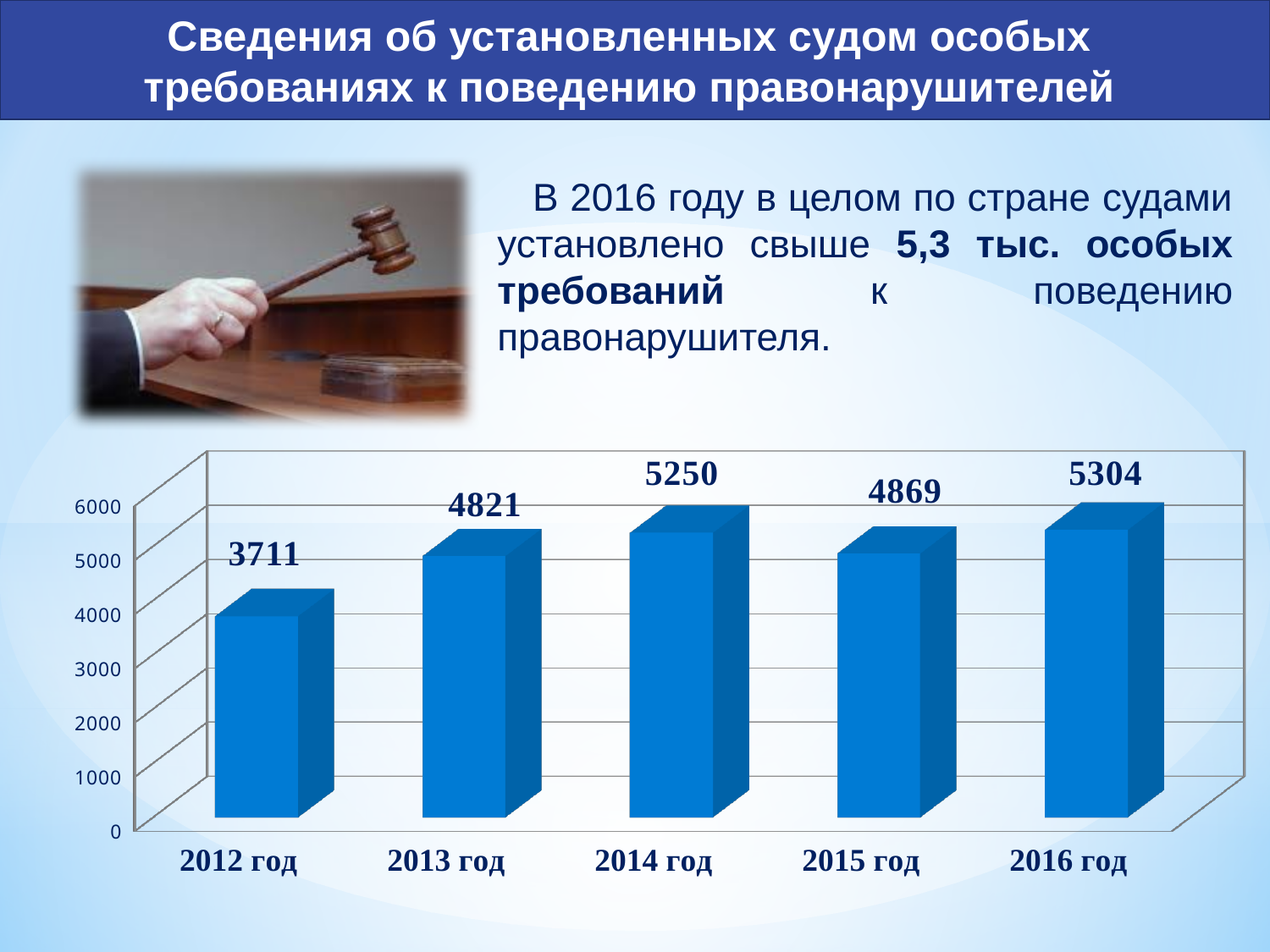
What is the value for 2012 год? 3711 What is the difference between the values for 2013 год and 2012 год? 1110 Does the value rise or fall from 2014 год to 2015 год? fall Which year has the highest value? 2016 год Is the value for 2012 год greater or less than 4000? less Which is larger, the value for 2014 год or the value for 2015 год? 2014 год What kind of chart is shown on the slide? bar chart Which year has the lowest value? 2012 год What is the difference between the values for 2016 год and 2015 год? 435 How many years are shown on the chart? 5 What is the value for 2016 год? 5304 What is the value for 2014 год? 5250